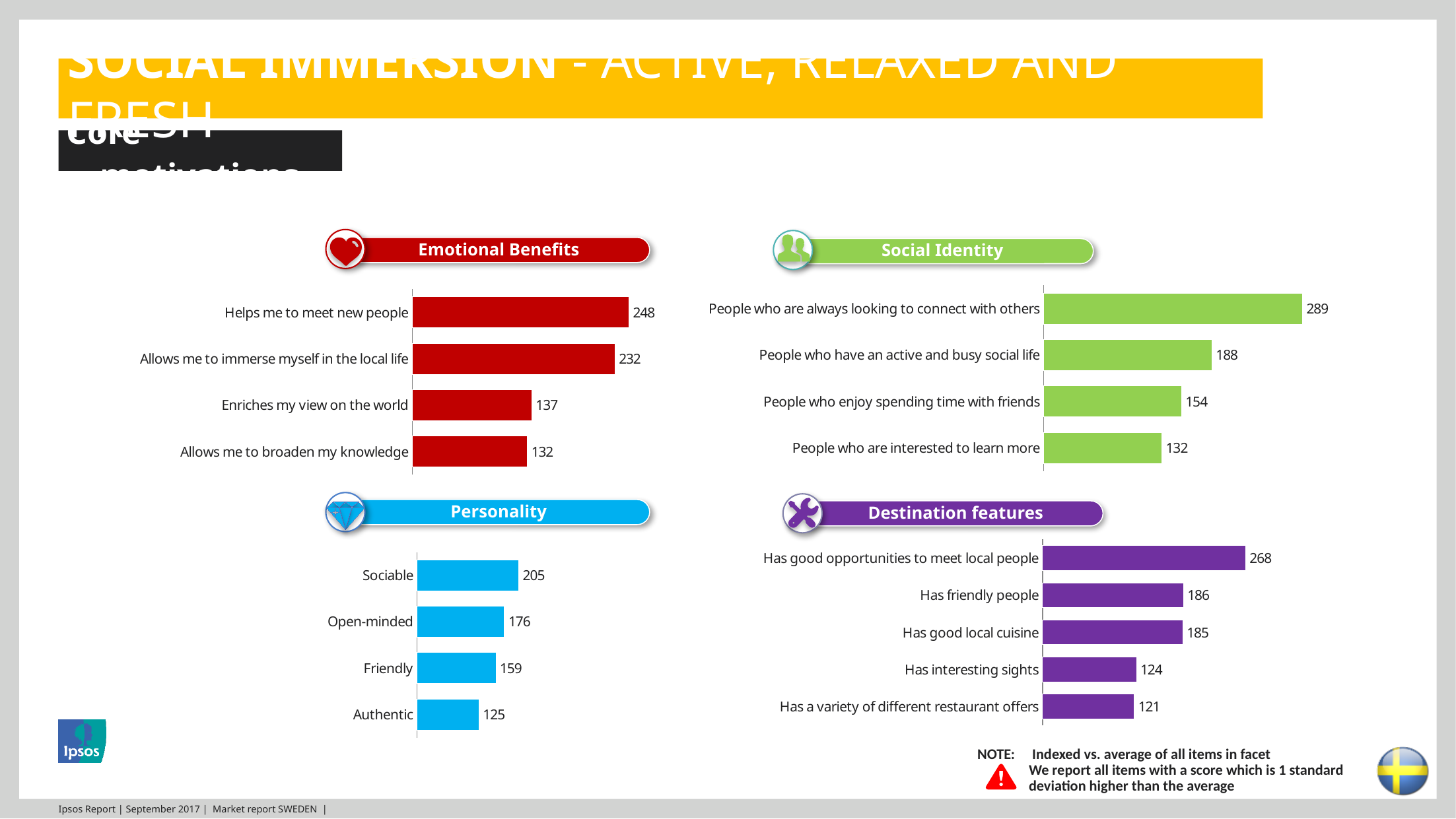
In the Emotional Benefits chart, what is the difference between "Helps me to meet new people" and "Allows me to immerse myself in the local life"? 16 In the Emotional Benefits chart, what is the value for "Helps me to meet new people"? 248 In the Social Identity chart, what is the value for "People who enjoy spending time with friends"? 154 In the Personality chart, which is larger: "Sociable" or "Friendly"? Sociable In the Destination features chart, which category has the lowest value? Has a variety of different restaurant offers In the Emotional Benefits chart, how many categories are shown? 4 In the Destination features chart, how many categories are shown? 5 In the Personality chart, what is the value for "Open-minded"? 176 What colour are the bars in the Destination features chart? Purple In the Destination features chart, what is the difference between "Has good opportunities to meet local people" and "Has friendly people"? 82 What kind of chart is the Social Identity chart? Bar chart In the Social Identity chart, which category has the highest value? People who are always looking to connect with others